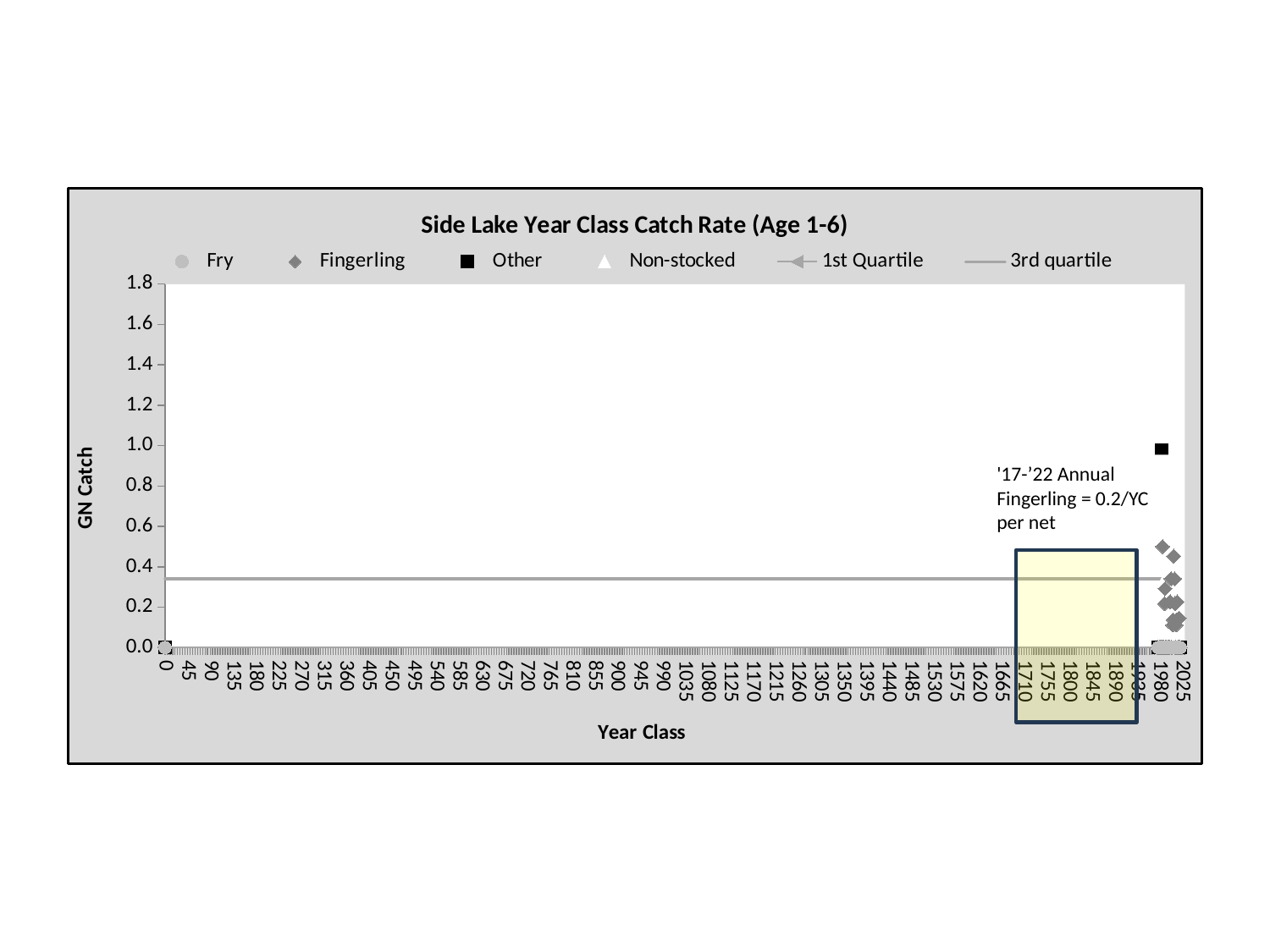
How many series does the legend list? 6 Is the value of the black square (Other) point greater or less than 1.2? less What is the highest value shown on the vertical axis? 1.8 Is the horizontal 3rd quartile line greater or less than 0.2? greater What kind of chart is shown on the slide? Scatter chart According to the annotation, what is the '17-'22 annual fingerling catch rate? 0.2/YC per net What is the title of the chart? Side Lake Year Class Catch Rate (Age 1-6) Is the horizontal 3rd quartile line greater or less than 0.6? less What is the label of the vertical axis? GN Catch